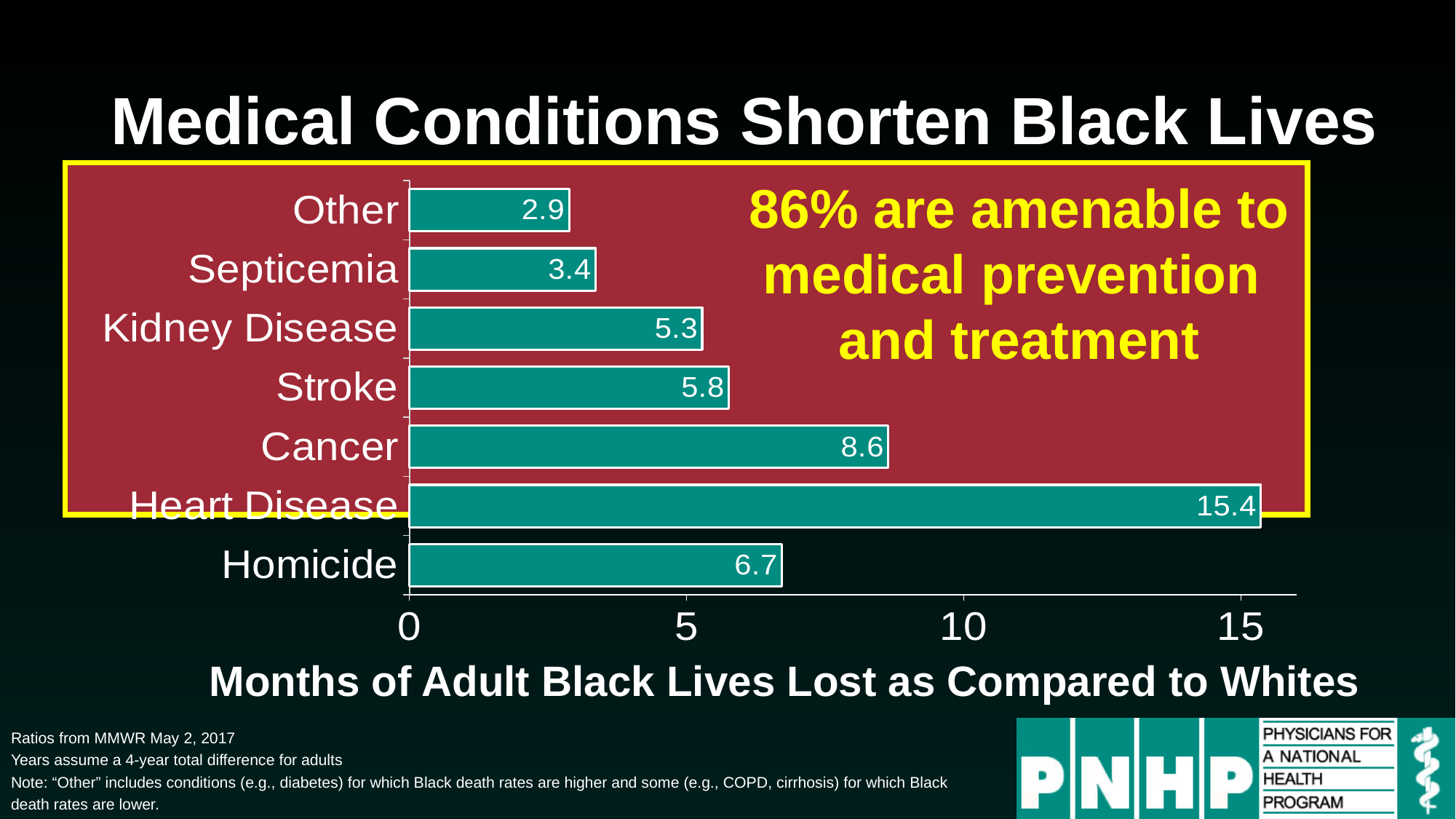
What is the value for Kidney Disease? 5.3 Which is larger, the value for Homicide or the value for Stroke? Homicide How many categories are shown in the chart? 7 Which category has the highest value? Heart Disease What is the x-axis title of the chart? Months of Adult Black Lives Lost as Compared to Whites What is the difference between the values for Stroke and Septicemia? 2.4 What is the value for Homicide? 6.7 Is the value for Cancer greater or less than 10? less What is the difference between the values for Heart Disease and Cancer? 6.8 What kind of chart is shown on the slide? bar chart What is the value for Heart Disease? 15.4 Which category has the lowest value? Other